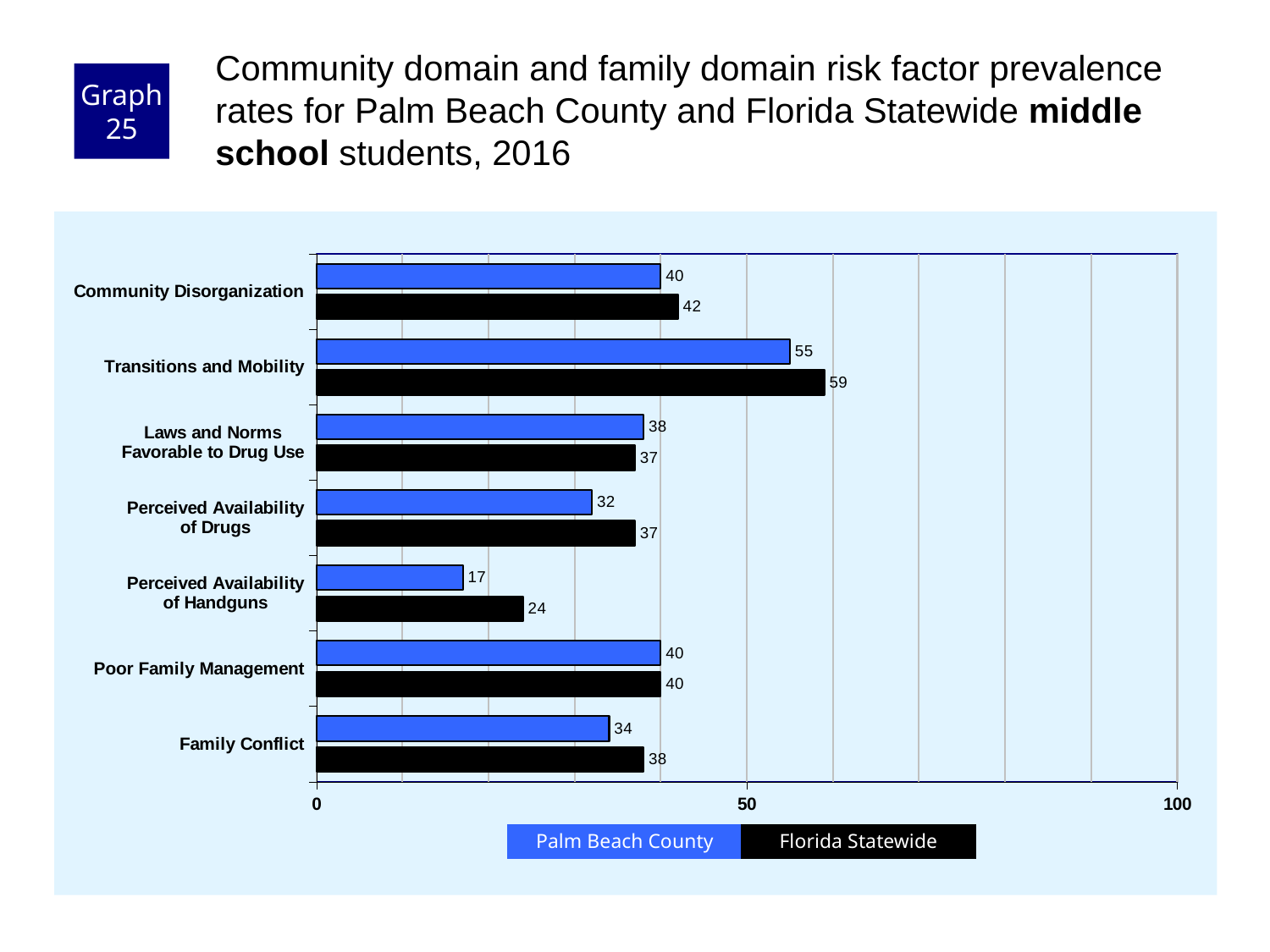
How many series does the legend list? 2 What is the Palm Beach County value for Transitions and Mobility? 55 What is the Florida Statewide value for Family Conflict? 38 Which is larger for Perceived Availability of Drugs: the Palm Beach County value or the Florida Statewide value? Florida Statewide Is the Florida Statewide value for Transitions and Mobility greater or less than 50? greater What is the difference between the Florida Statewide and Palm Beach County values for Perceived Availability of Handguns? 7 Which risk factor has the lowest Palm Beach County value? Perceived Availability of Handguns What kind of chart is shown on the slide? Bar chart Which risk factor has the highest Florida Statewide value? Transitions and Mobility What is the Florida Statewide value for Perceived Availability of Handguns? 24 How many risk factor categories are shown on the chart? 7 What is the difference between the Florida Statewide and Palm Beach County values for Transitions and Mobility? 4